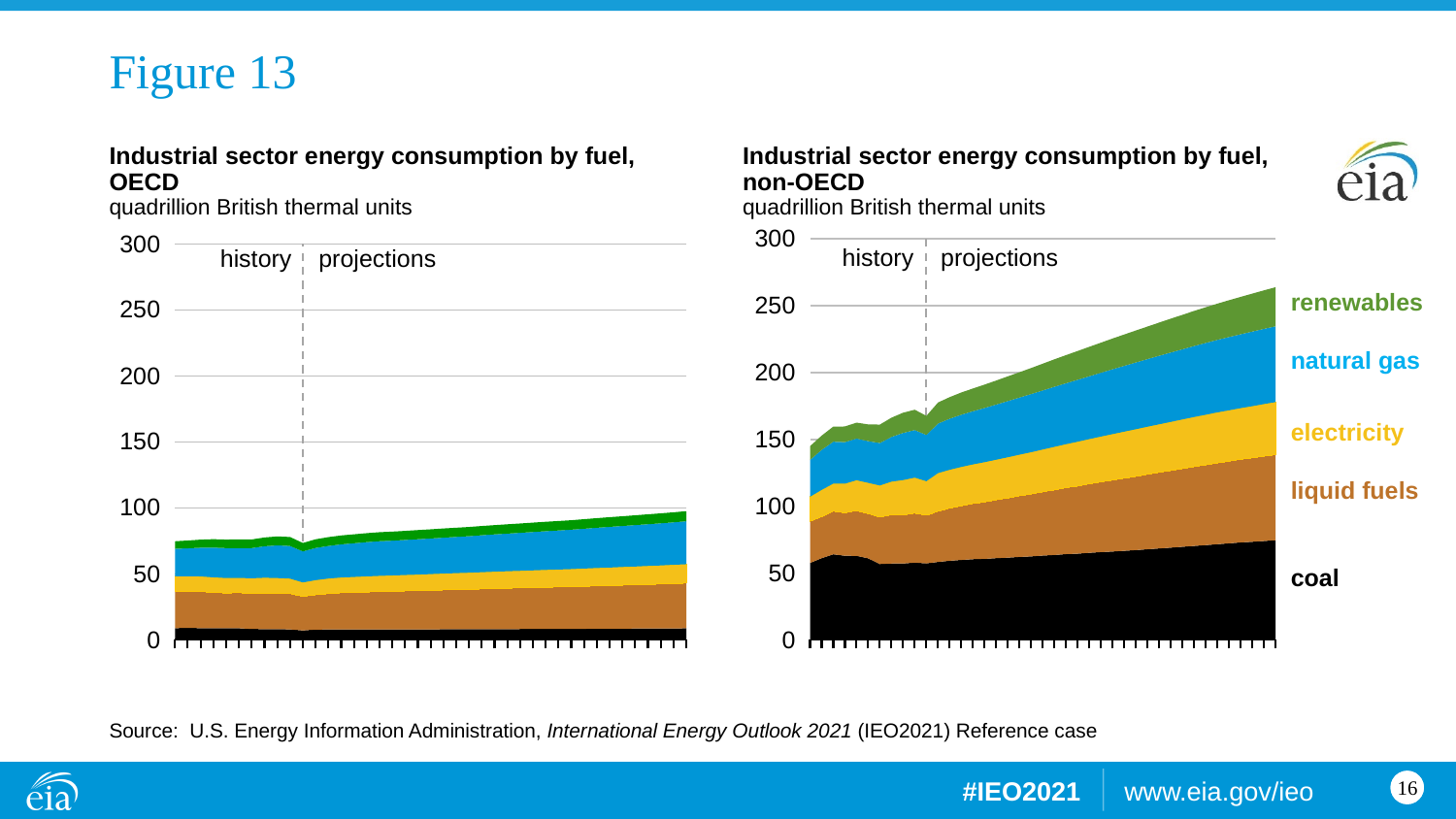
In the OECD chart, is the total industrial energy consumption at the start of the history period greater or less than 100? less In the non-OECD chart, is the total industrial energy consumption at the end of the projection period greater or less than 250? greater In the non-OECD chart, is coal consumption at the end of the projection period greater or less than 50? greater What unit of measurement is used on both charts? quadrillion British thermal units At the end of the projection period, which chart shows the larger total industrial energy consumption, OECD or non-OECD? non-OECD What kind of chart is the 'Industrial sector energy consumption by fuel, non-OECD' chart? stacked area chart How many fuel series does the legend of the non-OECD chart list? 5 In the OECD chart, does total industrial energy consumption rise or fall over the projection period? rise In the non-OECD chart, does total industrial energy consumption rise or fall over the projection period? rise Which fuel is shown at the bottom of the stack in the non-OECD chart? coal